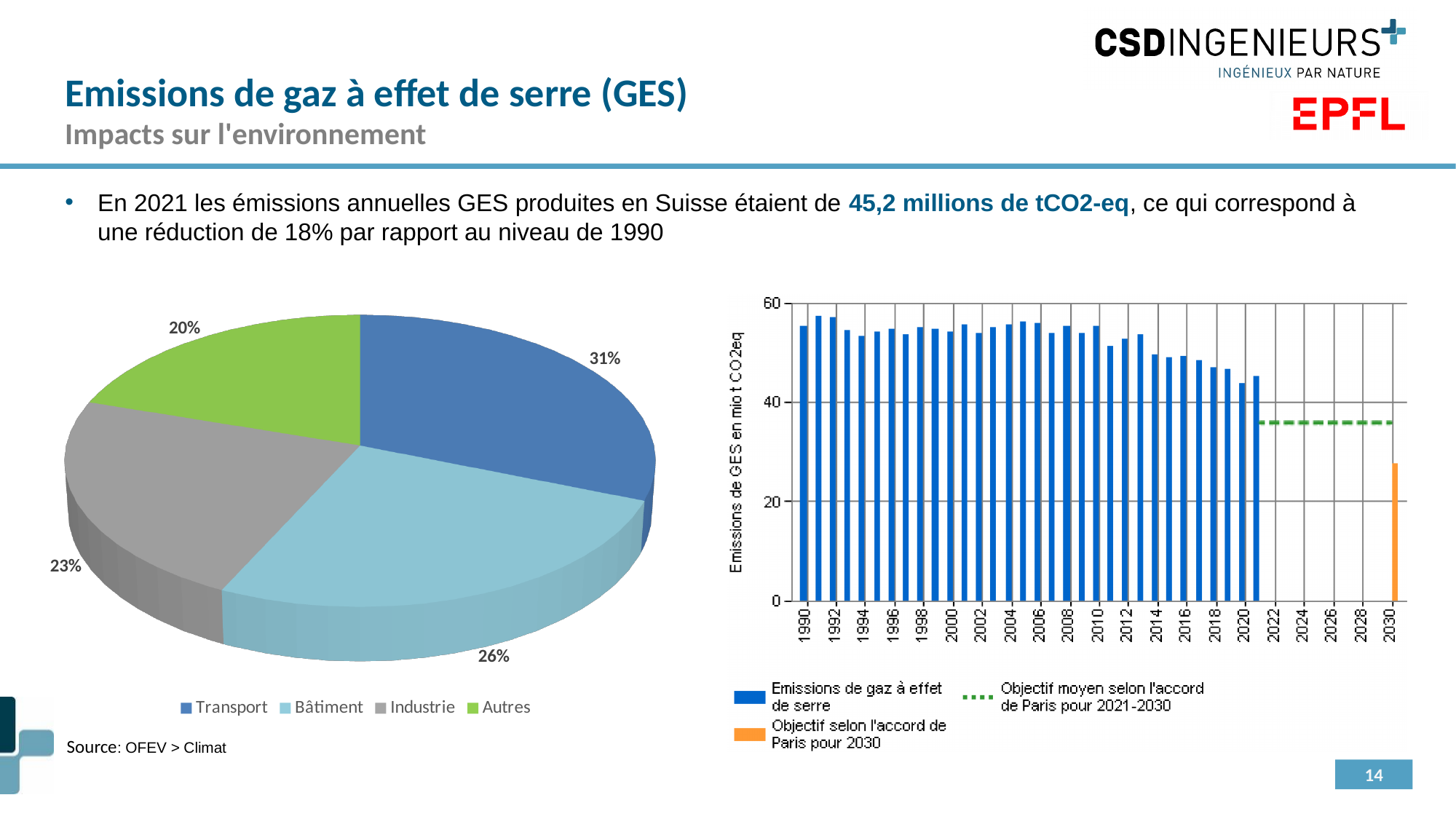
On the pie chart, what is the difference in percentage points between Transport and Autres? 11 percentage points On the right-hand chart, is the emissions value for 2021 greater or less than 40? greater On the pie chart, what share is shown for Industrie? 23% On the right-hand chart, is the orange 2030 target bar greater or less than 40? less What kind of chart is the chart on the right of the slide? Bar chart On the pie chart, which category has the largest share? Transport How many entries does the legend of the right-hand chart list? 3 On the pie chart, which is larger, Bâtiment or Industrie? Bâtiment On the pie chart, what share is shown for Bâtiment? 26% How many categories does the pie chart on the left show? 4 On the pie chart, which category has the smallest share? Autres On the pie chart, what share is shown for Transport? 31%